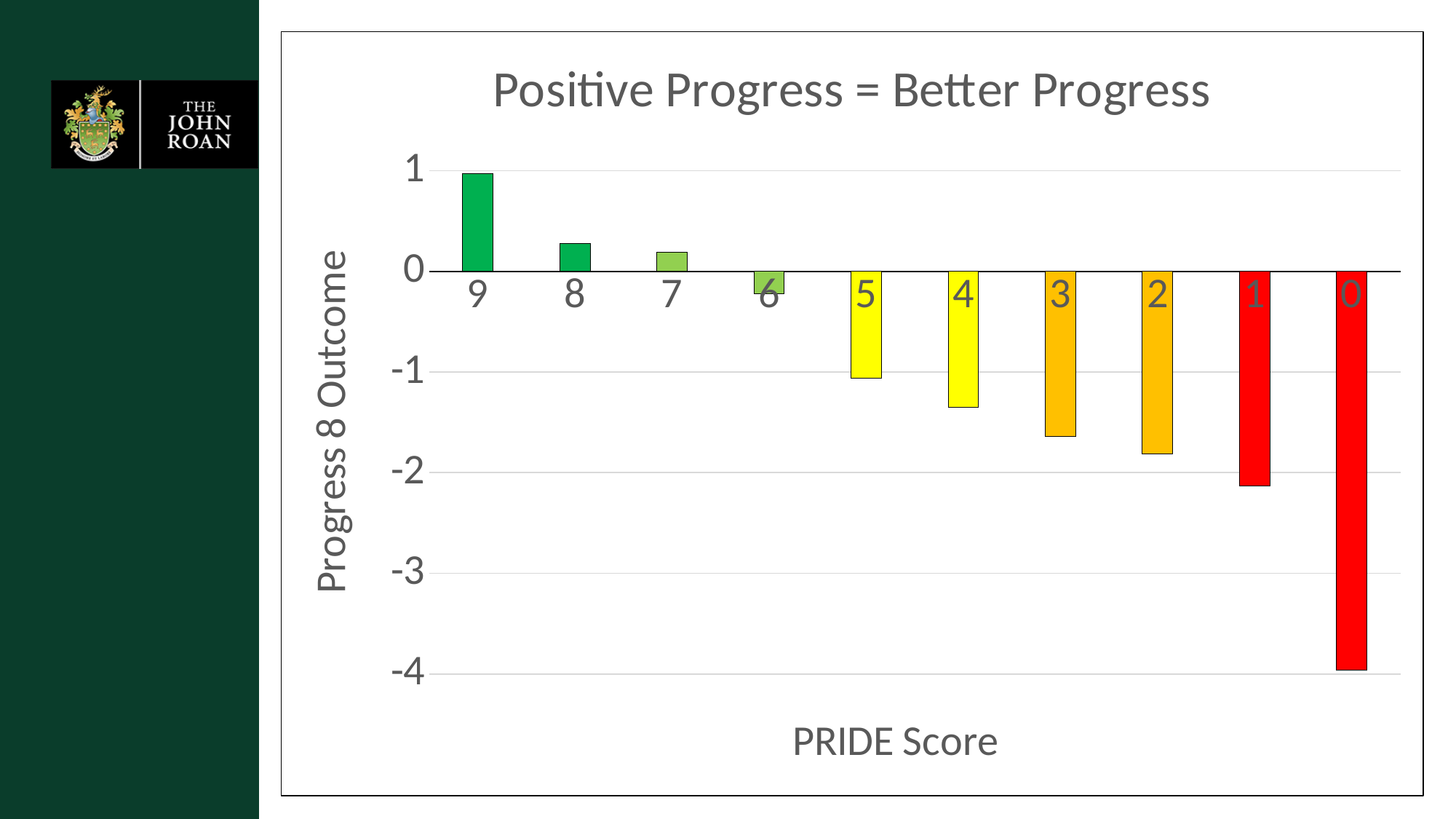
What is the title of the chart? Positive Progress = Better Progress Is the Progress 8 Outcome for PRIDE Score 2 greater or less than -2? greater Do the Progress 8 Outcome values rise or fall moving from left to right along the PRIDE Score axis? fall Is the Progress 8 Outcome for PRIDE Score 4 greater or less than -1? less Which has a higher Progress 8 Outcome, PRIDE Score 9 or PRIDE Score 8? PRIDE Score 9 What is the label on the vertical axis of the chart? Progress 8 Outcome Which PRIDE Score has the highest Progress 8 Outcome? 9 Is the Progress 8 Outcome for PRIDE Score 6 greater or less than 0? less How many PRIDE Score categories are plotted in the chart? 10 Which PRIDE Score has the lowest Progress 8 Outcome? 0 What type of chart is shown on the slide? bar chart